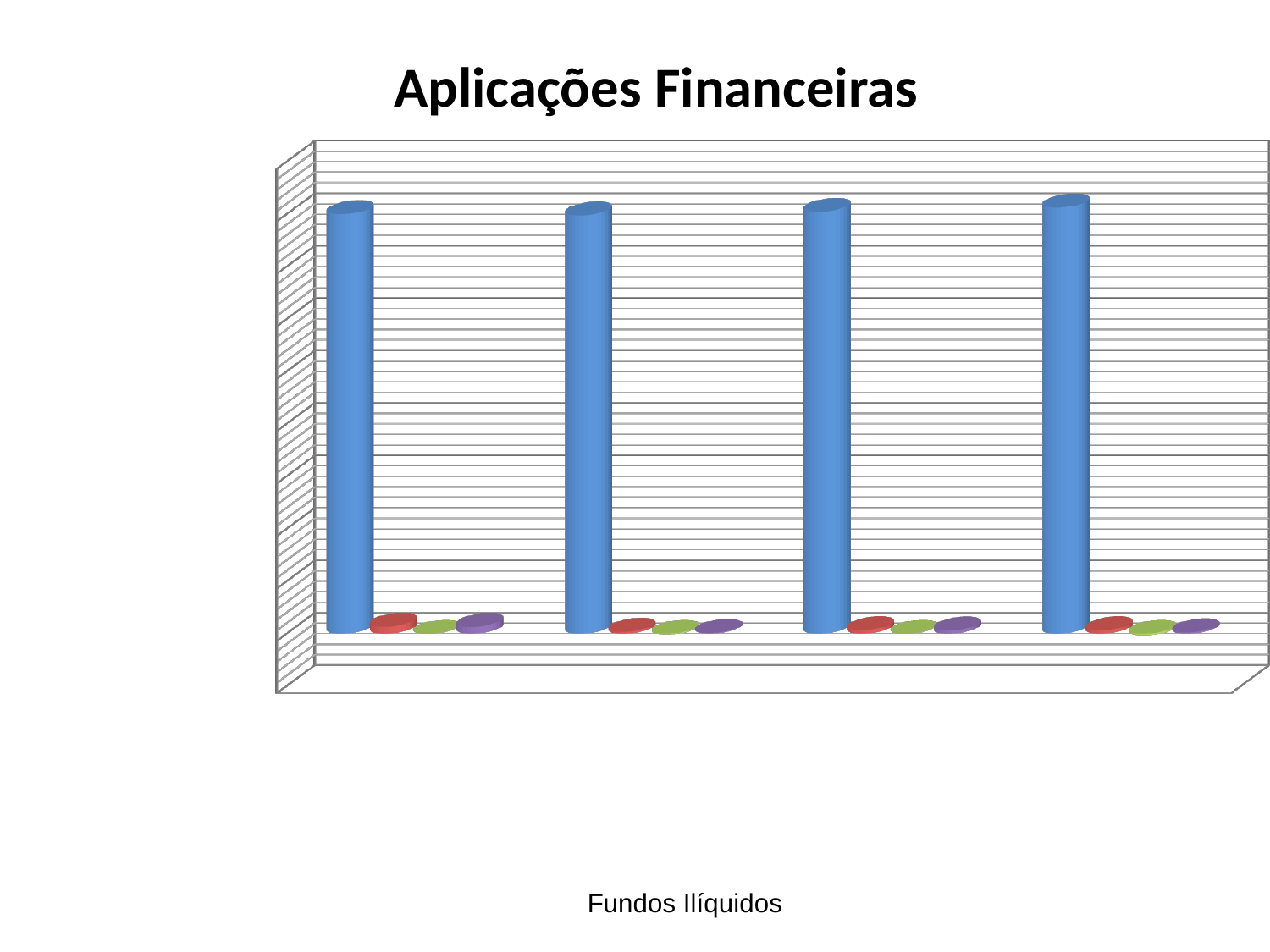
Which colour bar is the tallest in every group? blue What kind of chart is shown on the slide? bar chart How many groups of bars are plotted along the x axis? 4 In the last group on the right, is the blue bar or the purple bar taller? blue What is the title of the chart? Aplicações Financeiras In the first group from the left, is the blue bar or the red bar taller? blue What text appears below the chart? Fundos Ilíquidos How many bars are there in each group? 4